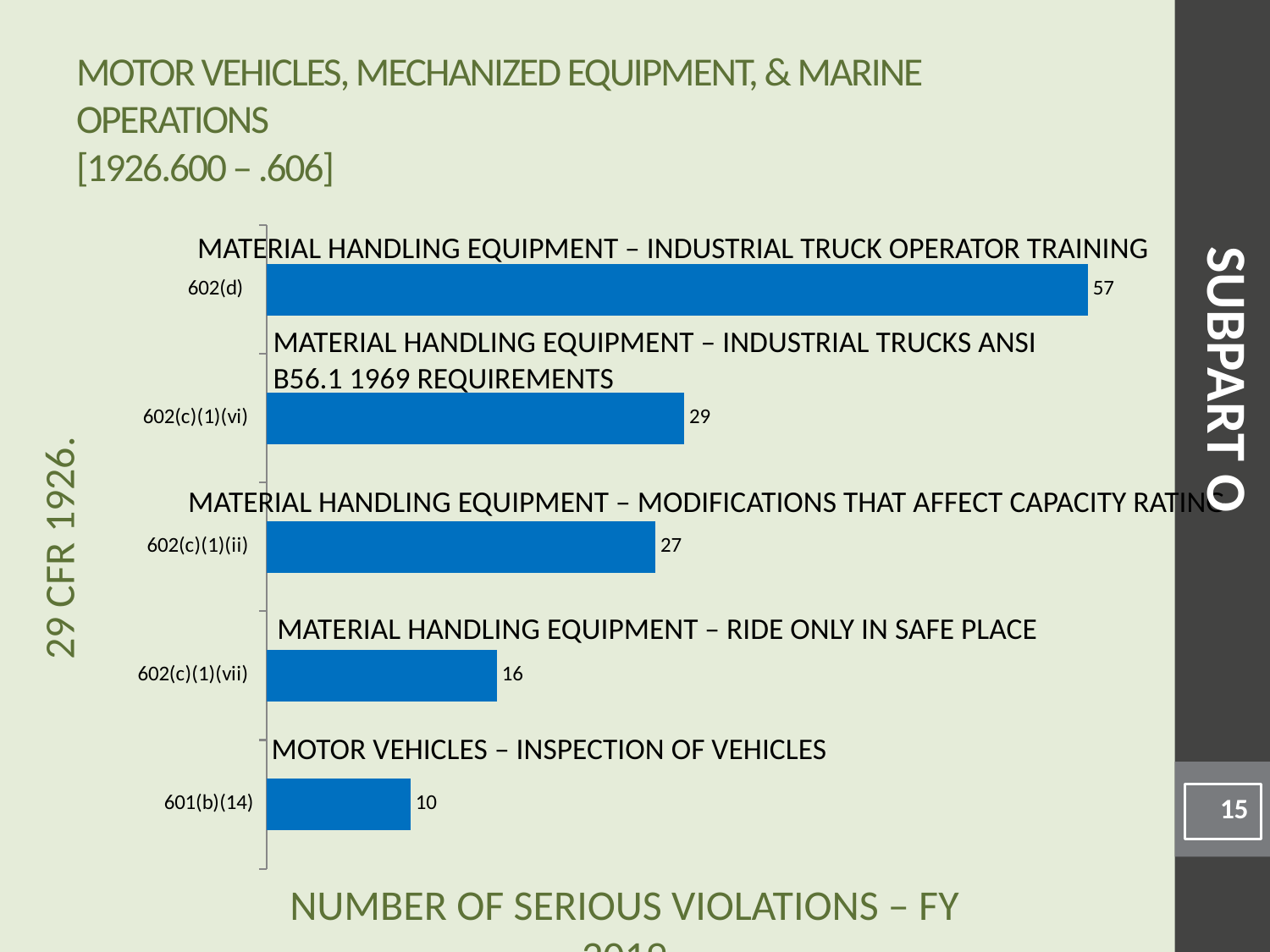
Which has more serious violations, 602(c)(1)(ii) or 602(c)(1)(vii)? 602(c)(1)(ii) What is the number of serious violations for 601(b)(14)? 10 What is the difference between the violations for 602(d) and 602(c)(1)(vi)? 28 What kind of chart is shown on the slide? Bar chart What is the total number of serious violations across all five standards shown? 139 What is the difference between the violations for 602(c)(1)(vii) and 601(b)(14)? 6 What is the number of serious violations for 602(d)? 57 Which standard has the lowest number of serious violations? 601(b)(14) What is the number of serious violations for 602(c)(1)(vi)? 29 How many standards are shown in the chart? 5 Which standard has the highest number of serious violations? 602(d) Which standard is labelled 'MOTOR VEHICLES – INSPECTION OF VEHICLES'? 601(b)(14)